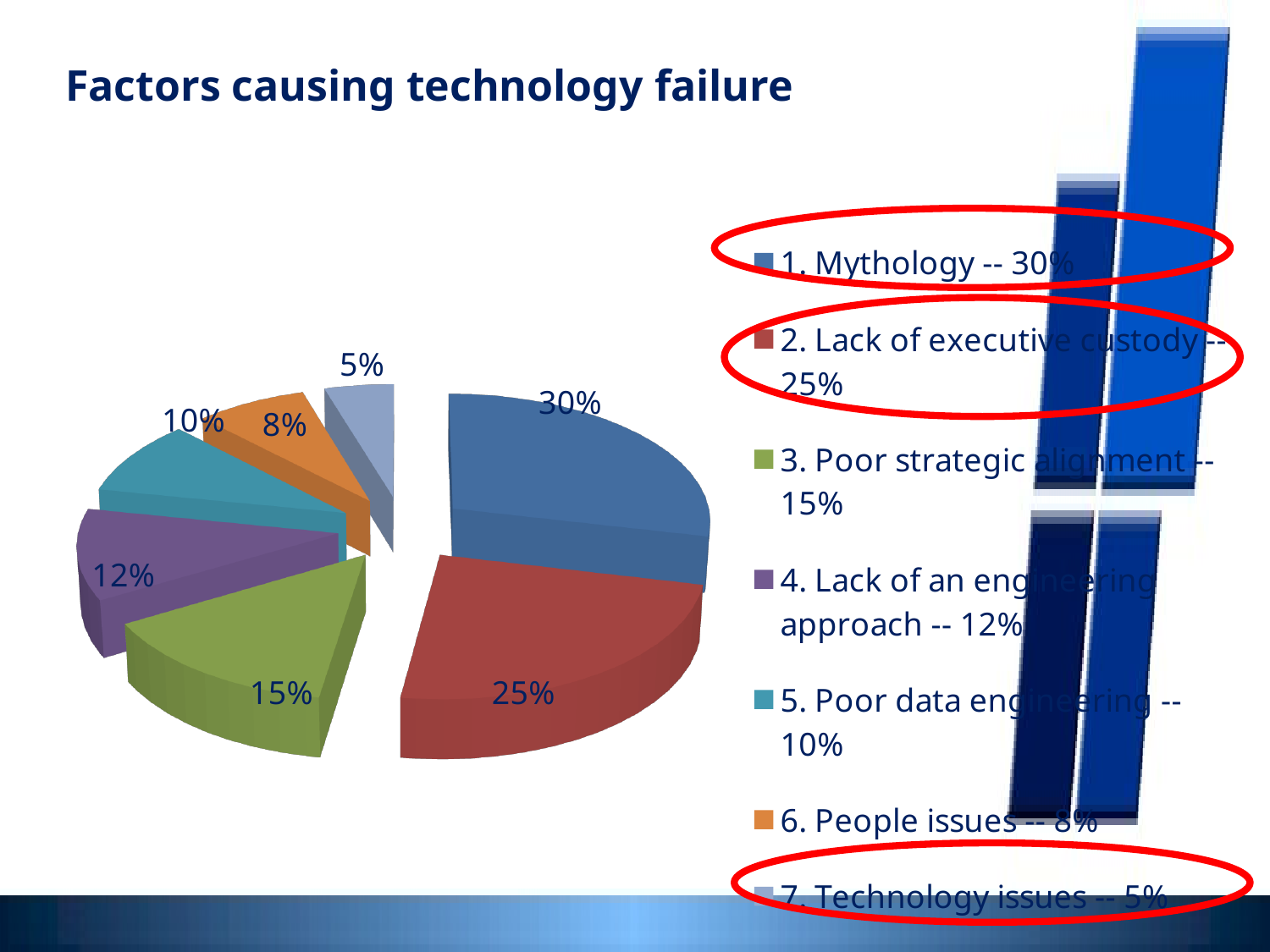
What is the difference in percentage points between Mythology and Lack of executive custody? 5 What share of the pie does Mythology account for? 30% What percentage is given for Lack of an engineering approach? 12% What value is shown for Poor strategic alignment? 15% What type of chart is shown on the slide? Pie chart What share is shown for People issues? 8% How many slices does the pie chart have? 7 What is the title of the chart on the slide? Factors causing technology failure Which factor has the smallest share of the pie? Technology issues Which factor has the largest share of the pie? Mythology Which is larger, the share for Poor data engineering or the share for People issues? Poor data engineering What percentage is shown for Lack of executive custody? 25%